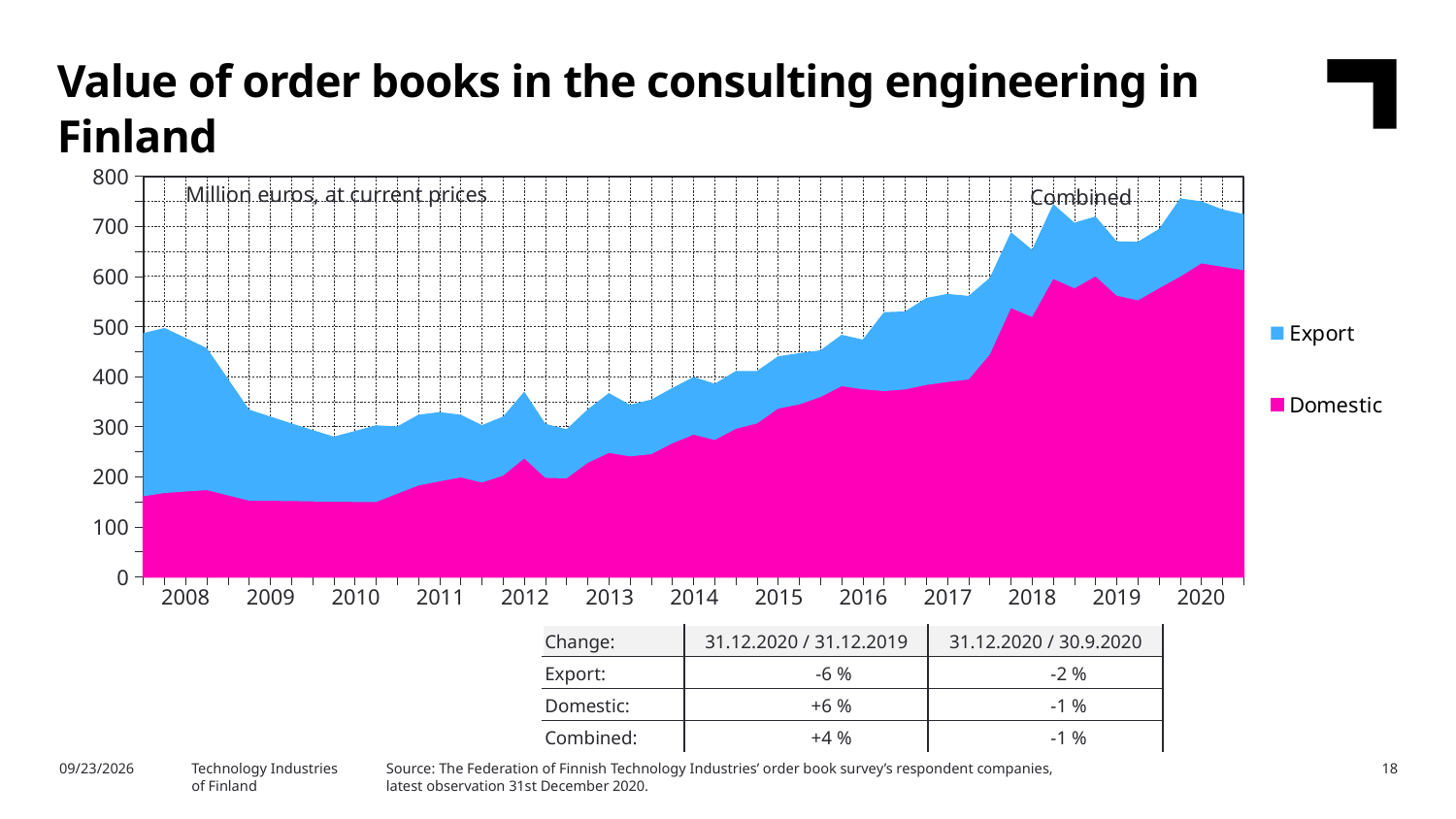
What kind of chart is shown on the slide? Stacked area chart Is the Domestic value in 2014 greater or less than 400? less Is the combined value at the end of 2020 greater or less than 600? greater How many series does the chart legend list? 2 How many years are labelled on the x axis of the chart? 13 Is the Domestic value at the start of 2008 greater or less than 200? less Which two series are listed in the chart legend? Export and Domestic Is the Domestic value larger at the end of 2020 or at the start of 2008? End of 2020 What unit is stated for the values in the chart? Million euros, at current prices Does the Domestic series rise or fall between 2010 and 2020? Rise At the start of 2008, which is larger, the Export or the Domestic value? Export